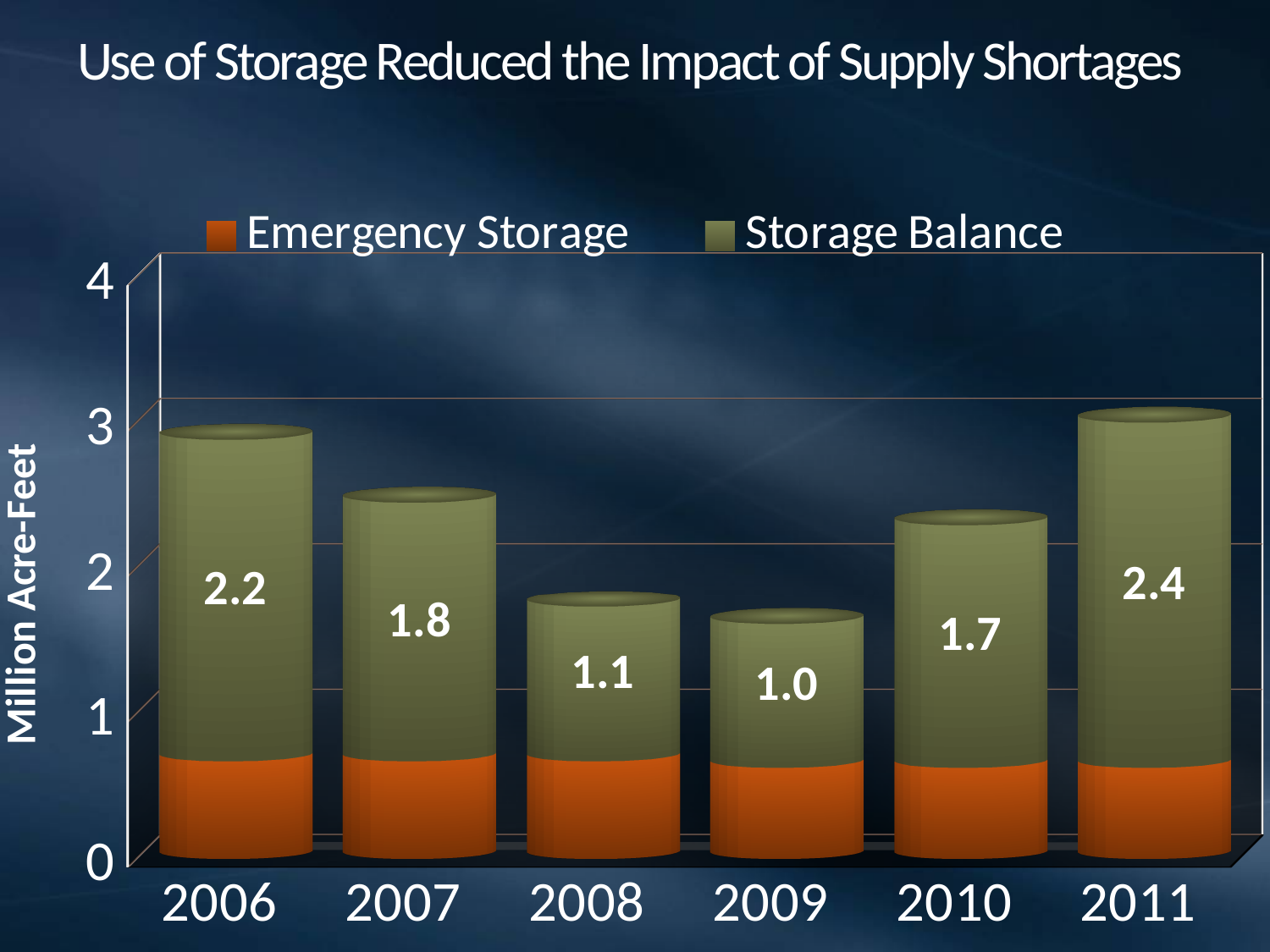
What is the Storage Balance value for 2006? 2.2 Is the total stacked value for 2009 greater or less than 2? less Which year has the lowest Storage Balance value? 2009 What is the Storage Balance value for 2011? 2.4 What is the Storage Balance value for 2009? 1.0 How many years are shown on the x axis? 6 Which year has the highest Storage Balance value? 2011 What kind of chart is shown on the slide? Stacked bar chart What is the difference between the Storage Balance values for 2011 and 2009? 1.4 How many series does the legend list? 2 Is the Emergency Storage value for 2006 greater or less than 1? less Which year has a larger Storage Balance value, 2007 or 2010? 2007